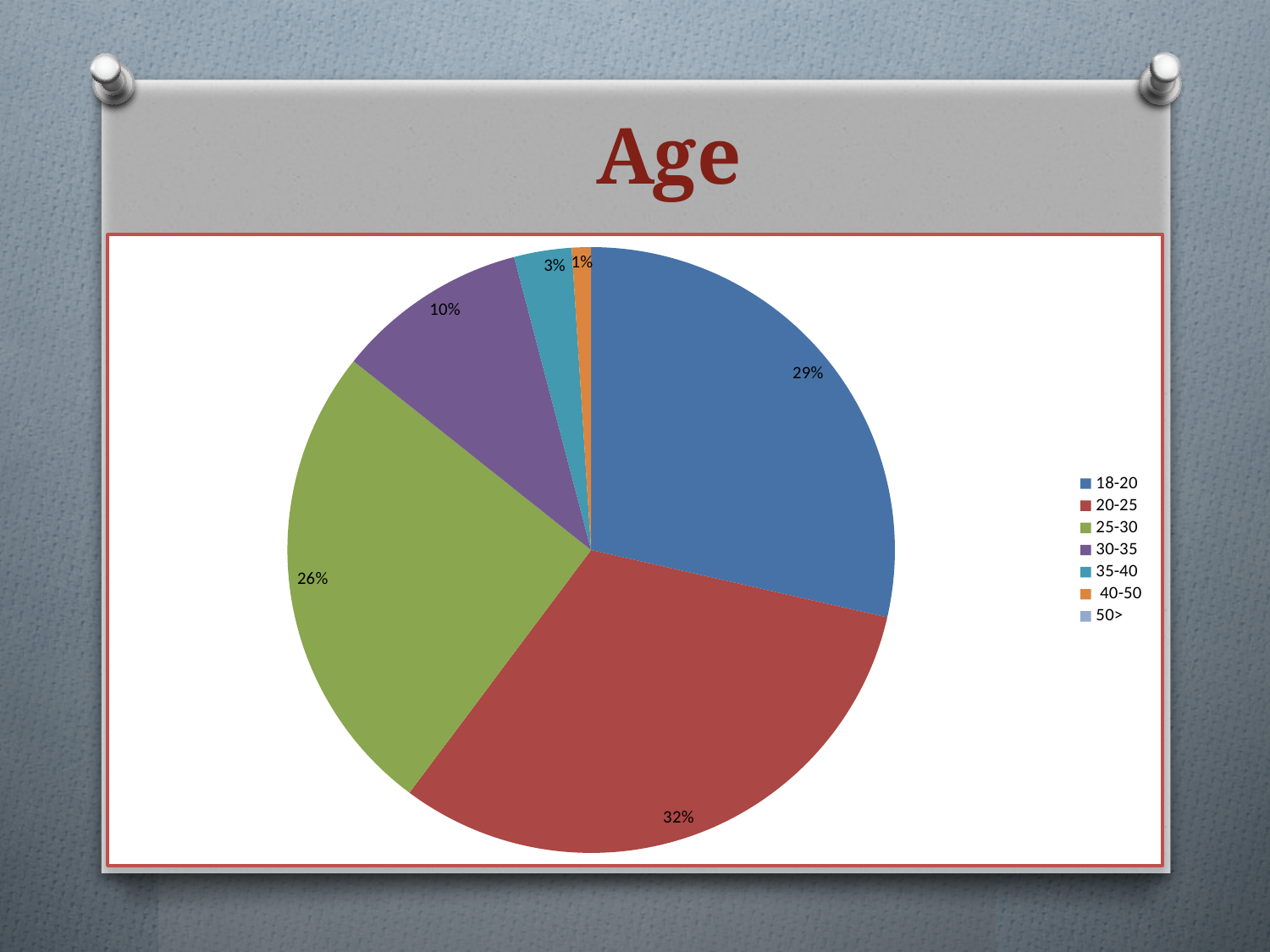
What is the title of the slide containing the pie chart? Age What percentage of the pie is the 35-40 age group? 3% What is the difference in percentage points between the 20-25 and 18-20 age groups? 3 What kind of chart is shown on the slide? pie chart What percentage of the pie is the 25-30 age group? 26% What percentage of the pie is the 30-35 age group? 10% Which age group has the largest share of the pie? 20-25 What percentage of the pie is the 20-25 age group? 32% What percentage of the pie is the 18-20 age group? 29% Which age group has a larger share, 25-30 or 30-35? 25-30 Which of the labelled slices has the smallest share of the pie? 40-50 How many age groups does the legend list? 7